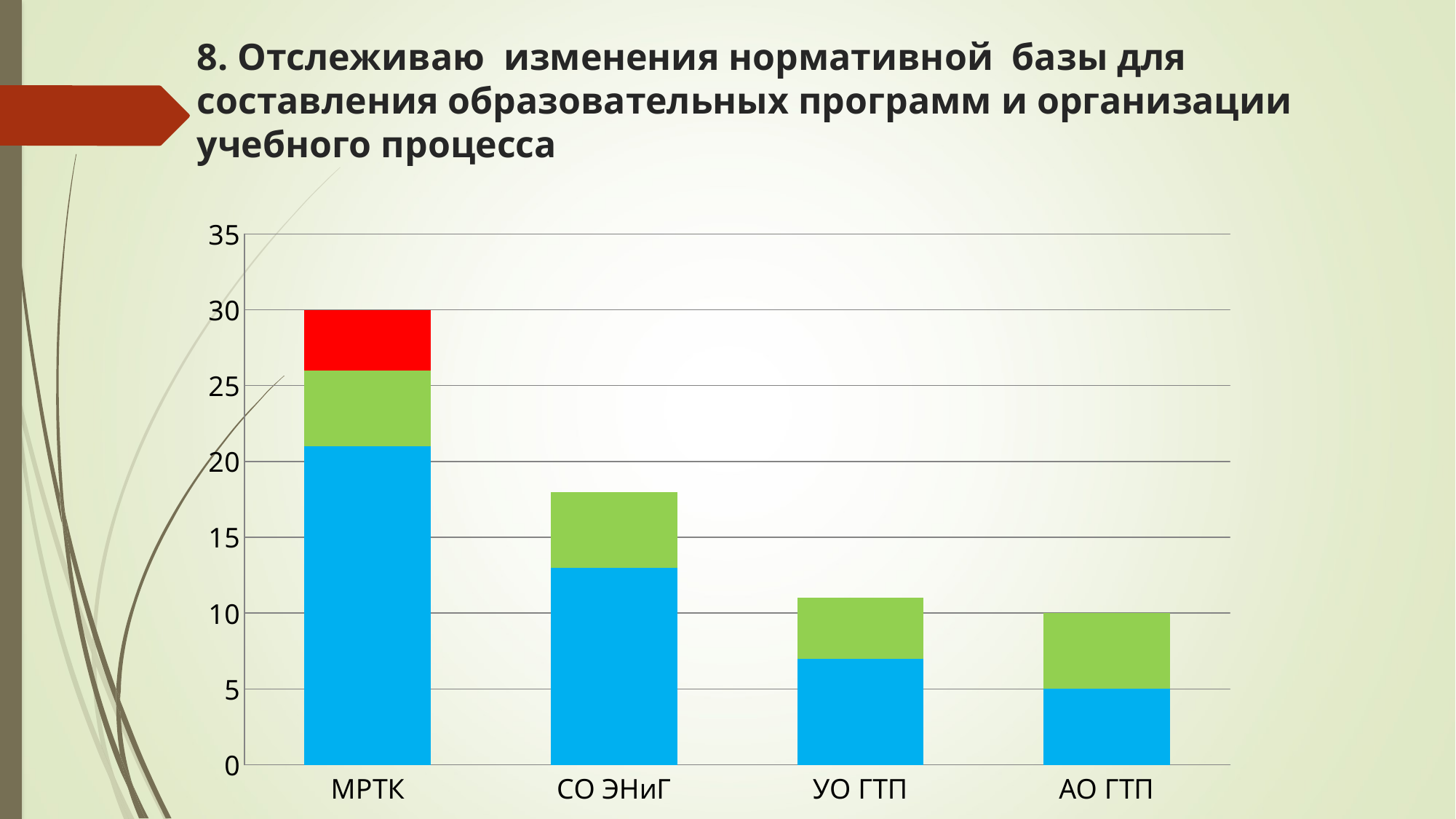
What is the total height of the stacked bar for АО ГТП? 10 What kind of chart is shown on the slide? Stacked bar chart Is the blue segment for СО ЭНиГ greater or less than 10? greater Is the total for УО ГТП greater or less than 15? less How many categories are shown on the x axis of the chart? 4 What is the total height of the stacked bar for МРТК? 30 Which category has the tallest stacked bar? МРТК Which stacked bar is taller, СО ЭНиГ or УО ГТП? СО ЭНиГ Is the total for СО ЭНиГ greater or less than 15? greater Which category is the only one with a red segment in its bar? МРТК Do the bar totals rise or fall from left to right along the x axis? Fall Which category has the shortest stacked bar? АО ГТП